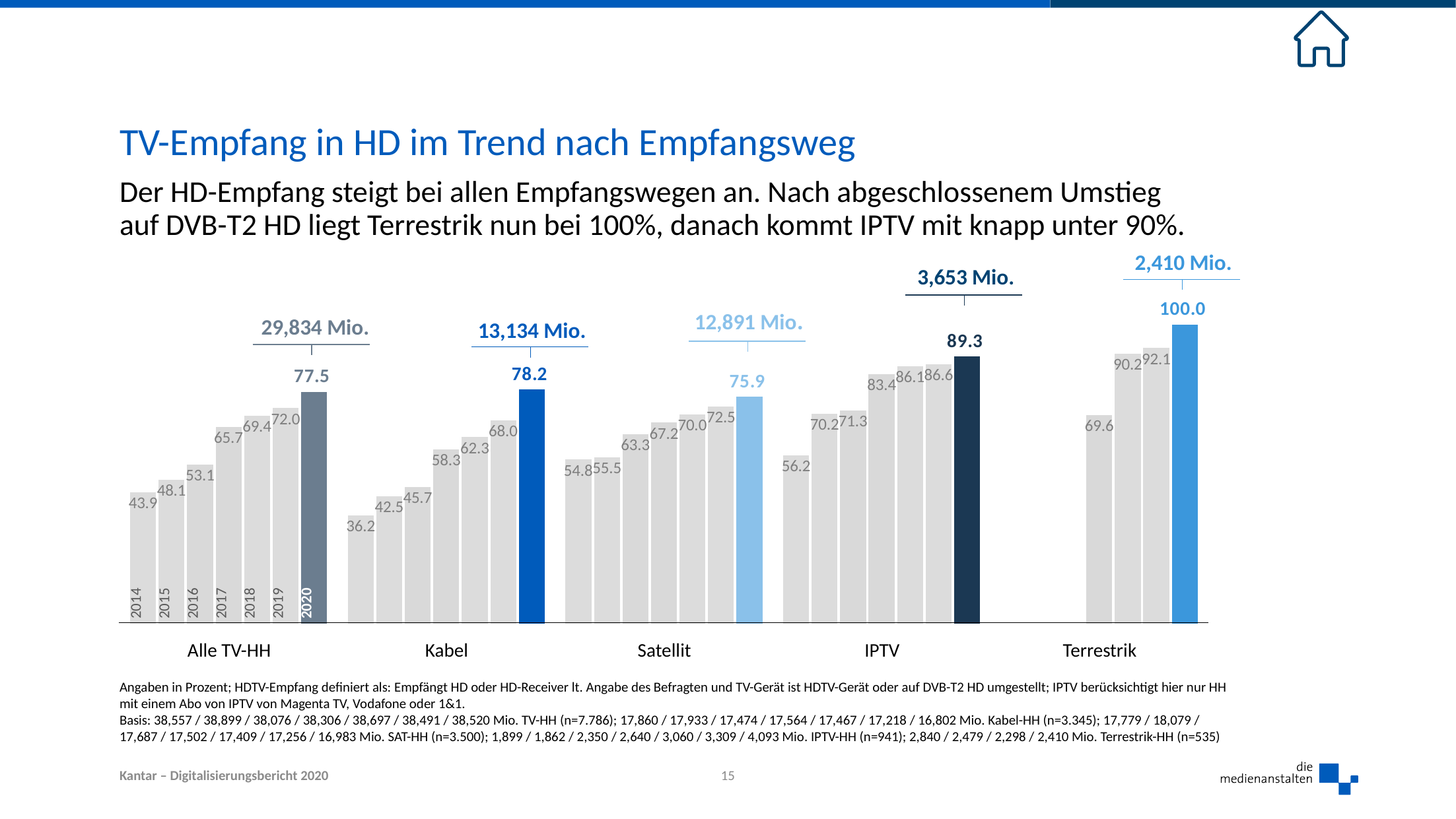
What is the 2020 value for IPTV? 89.3 How many reception path groups are shown on the x axis? 5 What kind of chart is shown on the slide? bar chart Do the values for IPTV rise or fall from 2014 to 2020? rise What is the 2014 value for Satellit? 54.8 Which reception path has the lowest 2014 value? Kabel By how much did the Alle TV-HH value increase from 2014 to 2020? 33.6 What is the 2020 value for Kabel? 78.2 Which is larger, the 2020 value for Kabel or the 2020 value for Satellit? Kabel Which reception path has the highest 2020 value? Terrestrik What household figure in Mio. is shown above the Terrestrik group? 2,410 Mio. What is the 2020 HD reception share for Alle TV-HH? 77.5